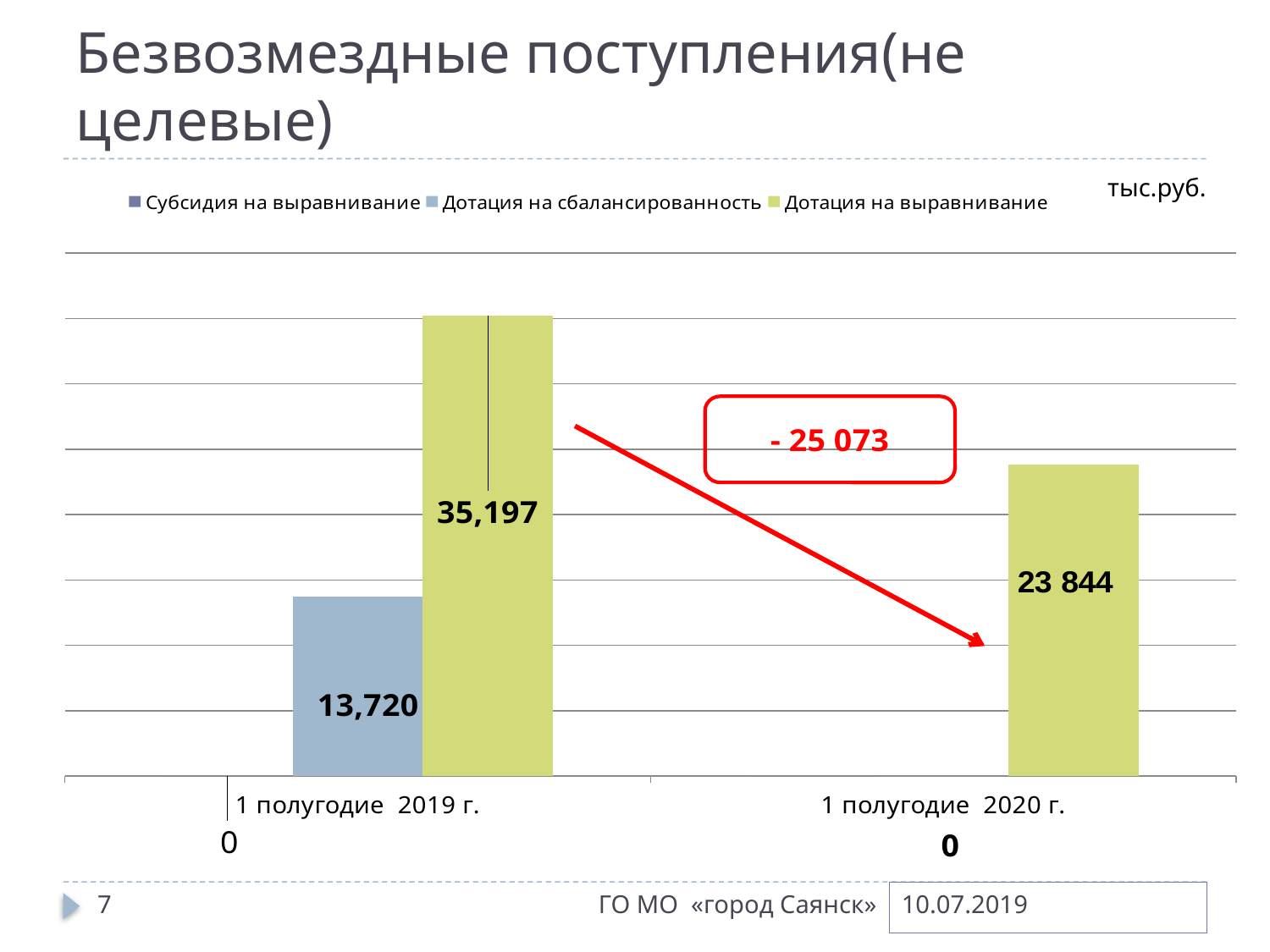
What is the difference between Дотация на выравнивание and Дотация на сбалансированность in 1 полугодие 2019 г.? 21,477 Is Дотация на выравнивание larger in 1 полугодие 2019 г. or in 1 полугодие 2020 г.? 1 полугодие 2019 г. Does Дотация на выравнивание rise or fall from 1 полугодие 2019 г. to 1 полугодие 2020 г.? fall What is the value of Дотация на выравнивание for 1 полугодие 2020 г.? 23 844 What kind of chart is shown on the slide? bar chart How many series does the legend list? 3 What is the value of Дотация на сбалансированность for 1 полугодие 2019 г.? 13,720 Which series has the highest value in 1 полугодие 2019 г.? Дотация на выравнивание By how much does Дотация на выравнивание in 1 полугодие 2019 г. exceed Дотация на выравнивание in 1 полугодие 2020 г.? 11,353 What is the value of Дотация на выравнивание for 1 полугодие 2019 г.? 35,197 How many periods (categories) are shown on the x axis? 2 What change is shown in the red callout box on the chart? - 25 073